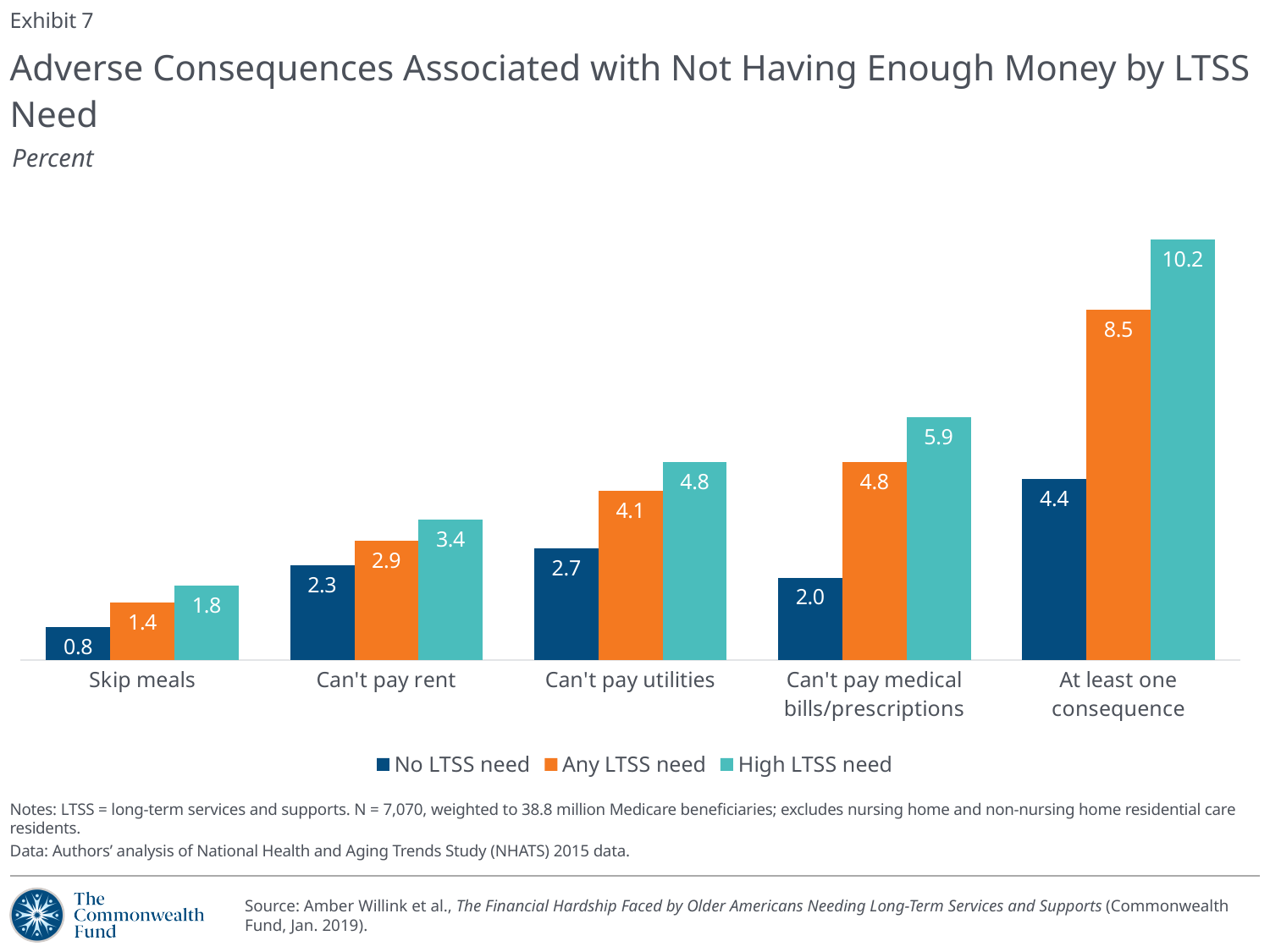
What is the value for High LTSS need in the At least one consequence category? 10.2 How many series does the legend list? 3 Do the High LTSS need values rise or fall from Skip meals to At least one consequence? Rise Which category has the lowest value for the High LTSS need series? Skip meals What is the value for Any LTSS need in the Can't pay utilities category? 4.1 What kind of chart is shown on the slide? Bar chart Which category has the highest value for the Any LTSS need series? At least one consequence Which is larger: the High LTSS need value for Can't pay rent or the No LTSS need value for At least one consequence? No LTSS need value for At least one consequence What is the value for No LTSS need in the Skip meals category? 0.8 How many categories are shown on the x axis? 5 What is the difference between the High LTSS need and No LTSS need values for At least one consequence? 5.8 What is the difference between the Any LTSS need and No LTSS need values for Can't pay medical bills/prescriptions? 2.8